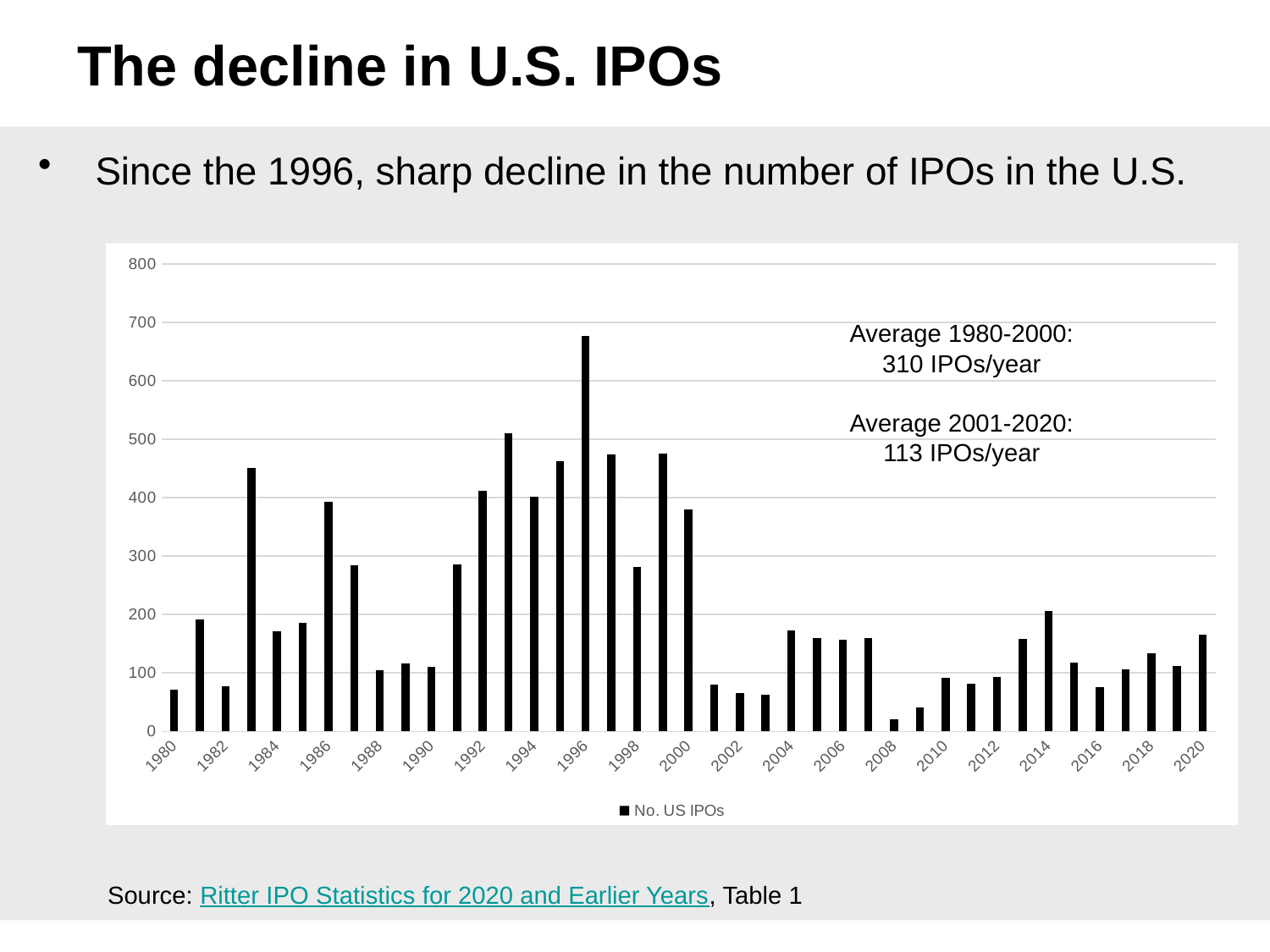
Is the value for 2020 greater or less than 100? greater Which year has the lowest number of U.S. IPOs? 2008 How many series does the legend list? 1 Is the value for 2008 greater or less than 100? less Do the values rise or fall from 1996 to 2003? fall According to the annotation on the chart, what was the average number of IPOs per year for 2001-2020? 113 IPOs/year Is the value for 1983 greater or less than 400? greater What kind of chart is shown on the slide? bar chart What is the name of the series shown in the legend? No. US IPOs Which year has the highest number of U.S. IPOs? 1996 Which year has more IPOs, 1996 or 2000? 1996